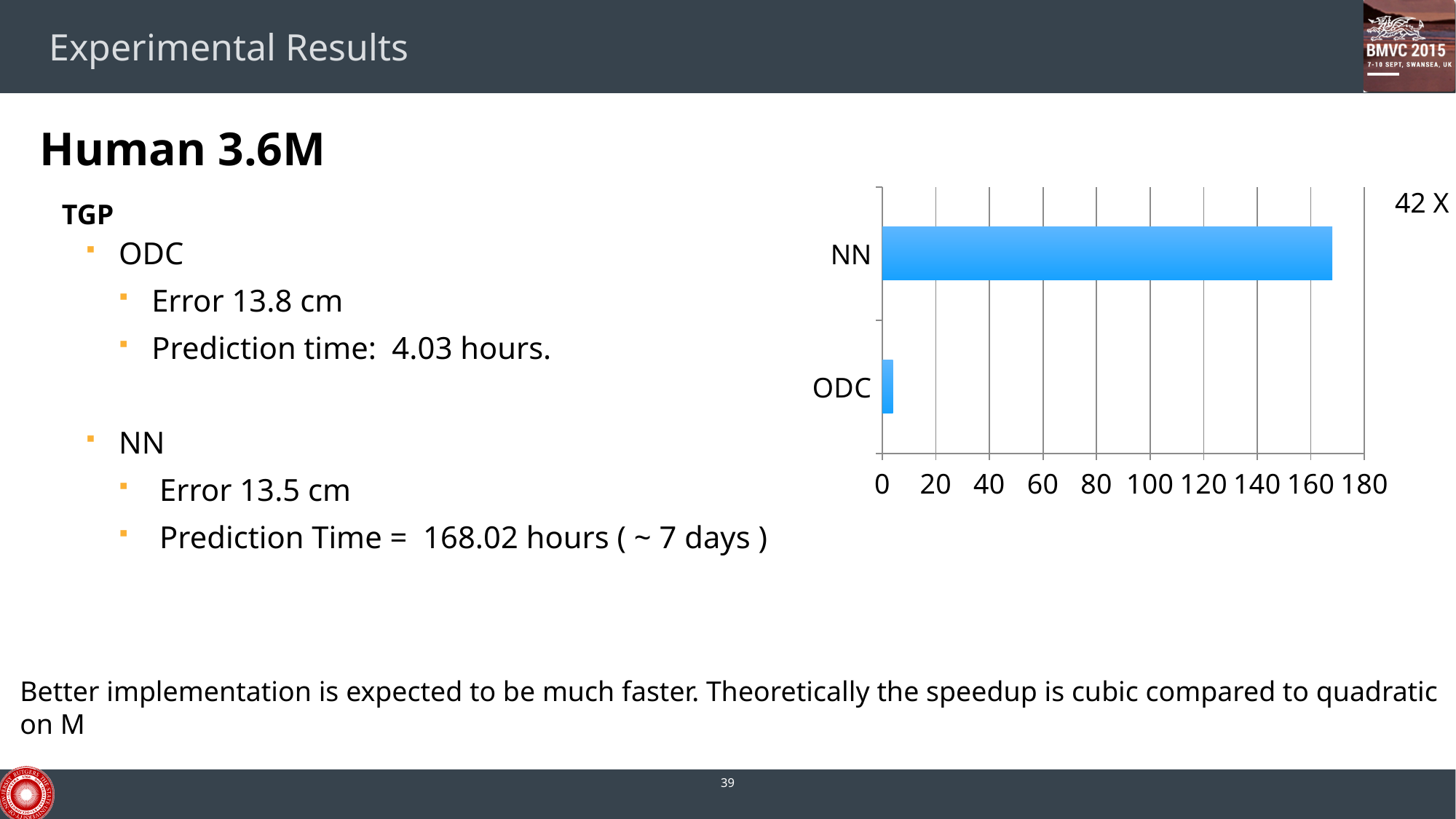
Which bar is longer, NN or ODC? NN How many categories does the bar chart show? 2 Which category has the shortest bar in the chart? ODC Which category has the longest bar in the chart? NN What kind of chart is shown on the slide? bar chart What is the highest tick value shown on the horizontal axis of the chart? 180 Is the value for NN greater or less than 160? greater Is the value for NN greater or less than 100? greater Is the value for ODC greater or less than 20? less What annotation is printed at the top right of the chart? 42 X